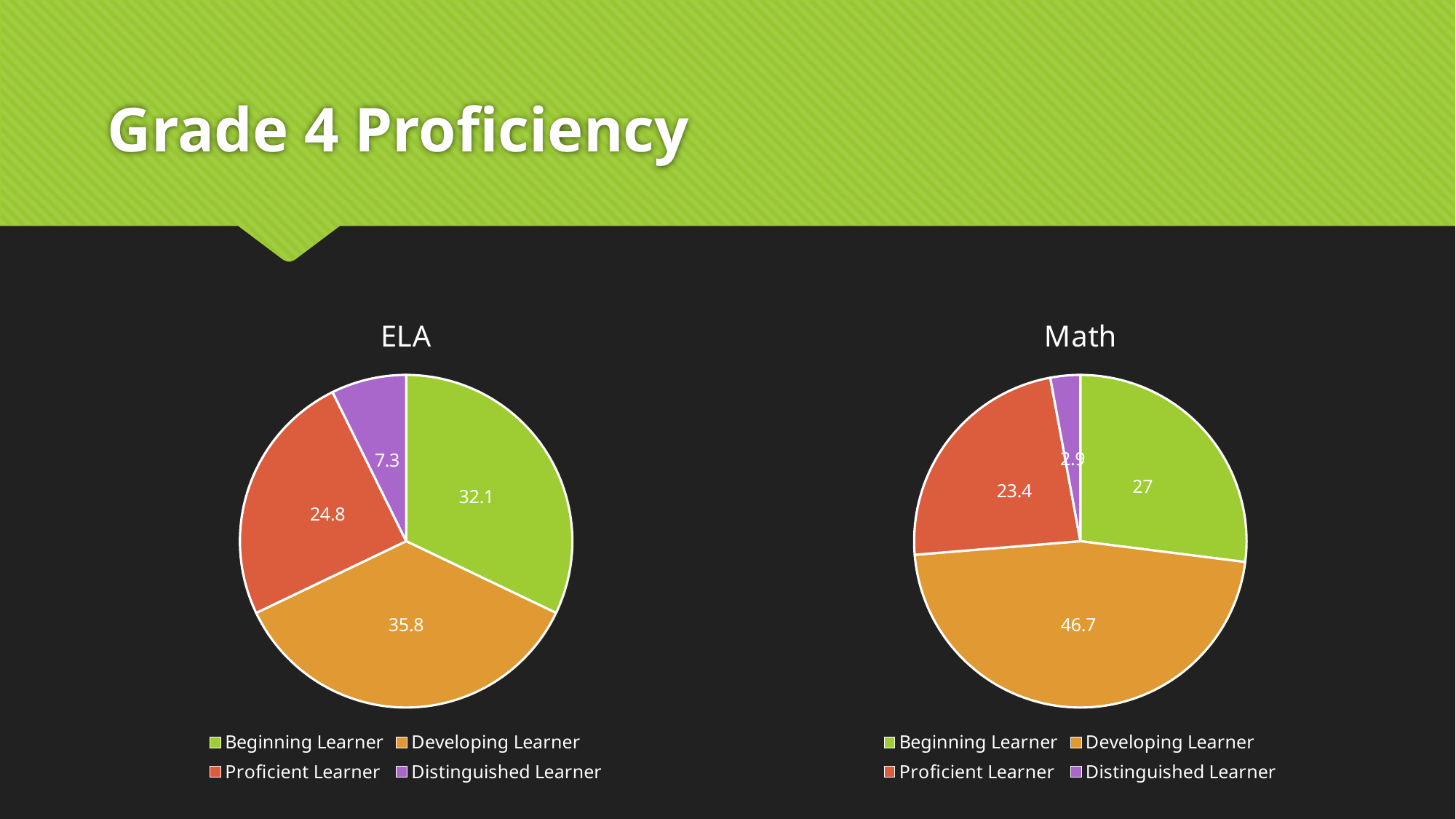
In the Math pie chart, which category has the smallest slice? Distinguished Learner In the Math pie chart, what is the value for Proficient Learner? 23.4 In the ELA pie chart, what is the value for Developing Learner? 35.8 Which chart has the larger value for Distinguished Learner, ELA or Math? ELA In the ELA pie chart, which category has the smallest slice? Distinguished Learner How many slices does the Math pie chart have? 4 In the Math pie chart, what is the difference between the Beginning Learner and Proficient Learner values? 3.6 How many entries does the legend of the ELA chart list? 4 In the Math pie chart, which category has the largest slice? Developing Learner In the ELA pie chart, what is the difference between the Developing Learner and Beginning Learner values? 3.7 What type of chart is used for ELA? Pie chart In the ELA pie chart, what is the value for Distinguished Learner? 7.3